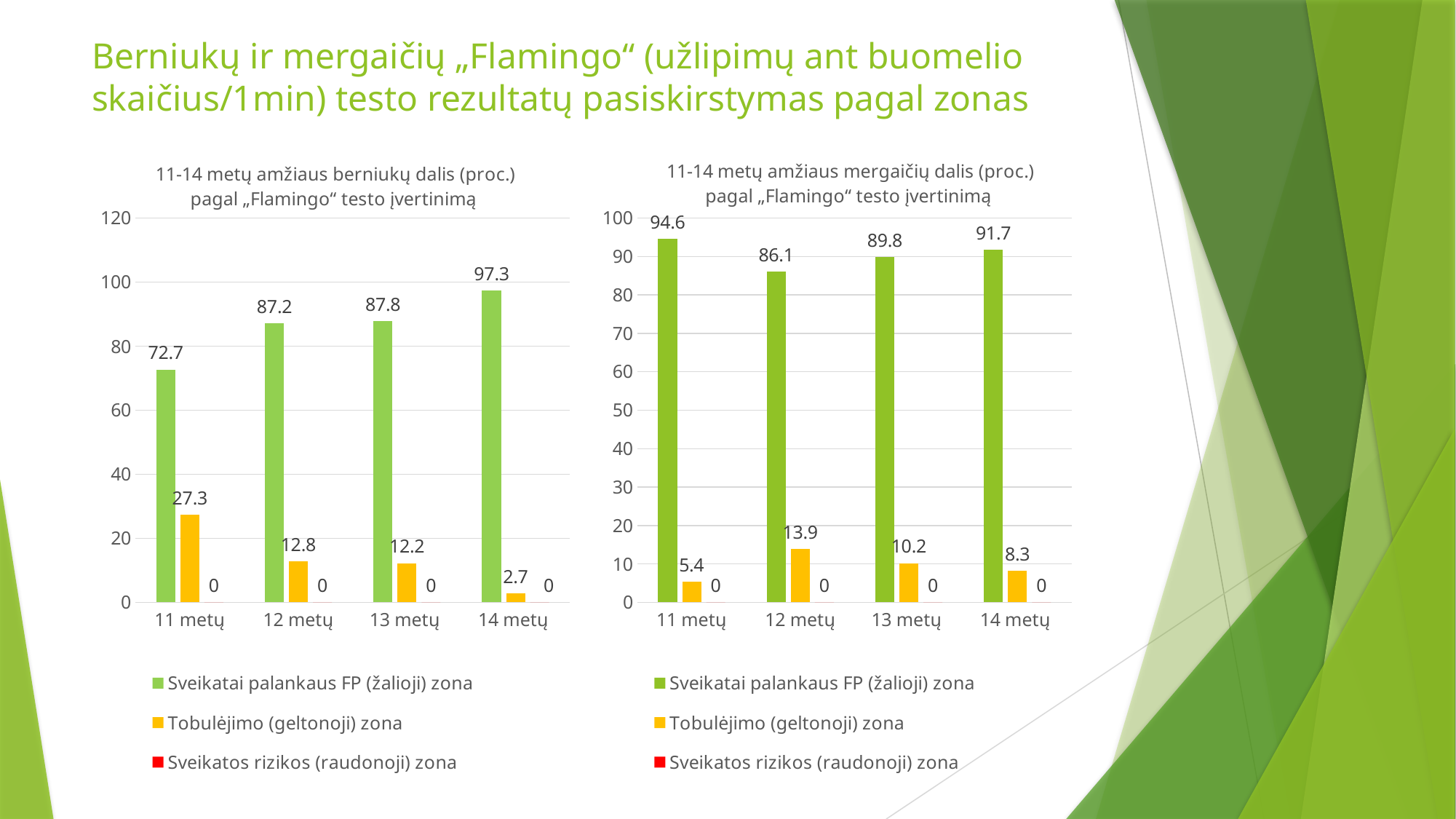
What kind of chart is the right chart (mergaičių)? bar chart In the right chart (mergaičių), which is larger: the Sveikatai palankaus FP (žalioji) zona value for 11 metų or for 13 metų? 11 metų In the right chart (mergaičių), which age group has the lowest value for the Sveikatai palankaus FP (žalioji) zona series? 12 metų In the left chart (berniukų), what is the value of the Sveikatai palankaus FP (žalioji) zona series for 14 metų? 97.3 In the left chart (berniukų), does the Tobulėjimo (geltonoji) zona series rise or fall from 11 metų to 14 metų? fall How many age groups are shown on the x axis of the right chart (mergaičių)? 4 In the left chart (berniukų), is the Sveikatai palankaus FP (žalioji) zona value for 11 metų greater or less than 80? less In the left chart (berniukų), what is the difference between the Sveikatai palankaus FP (žalioji) zona values for 14 metų and 11 metų? 24.6 In the left chart (berniukų), which age group has the highest value for the Tobulėjimo (geltonoji) zona series? 11 metų How many series does the legend of the left chart (berniukų) list? 3 In the right chart (mergaičių), what is the value of the Tobulėjimo (geltonoji) zona series for 12 metų? 13.9 In the right chart (mergaičių), what is the value of the Sveikatos rizikos (raudonoji) zona series for 14 metų? 0